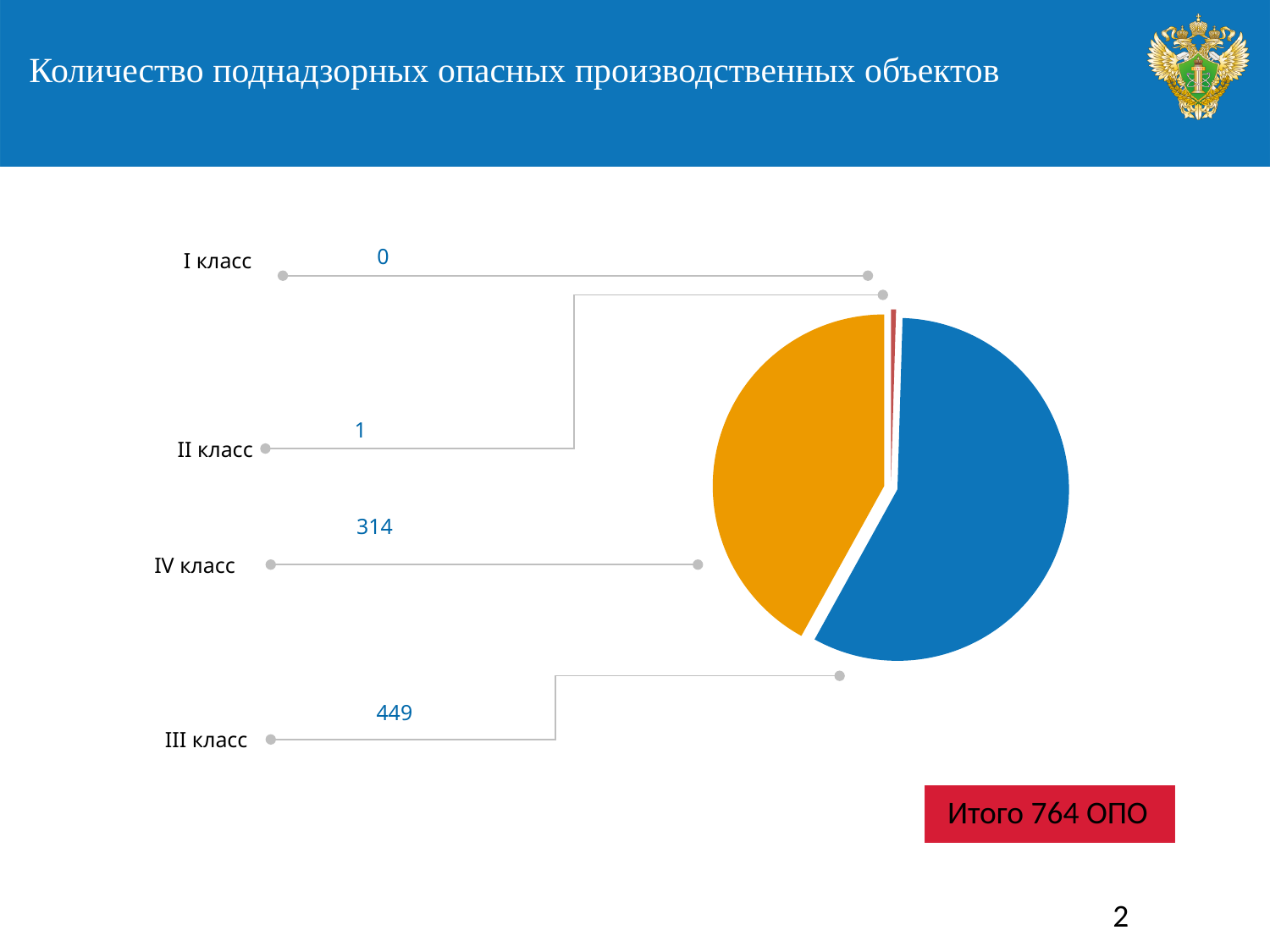
What total number of ОПО is stated on the slide? 764 Which category has the lowest value? I класс What is the value for IV класс? 314 What type of chart is shown on the slide? pie chart What is the title of the slide? Количество поднадзорных опасных производственных объектов Which is larger, the value for IV класс or the value for II класс? IV класс What is the difference between the values for III класс and IV класс? 135 How many categories are shown in the chart? 4 What is the value for III класс? 449 What is the value for I класс? 0 Which category has the highest value? III класс What is the value for II класс? 1